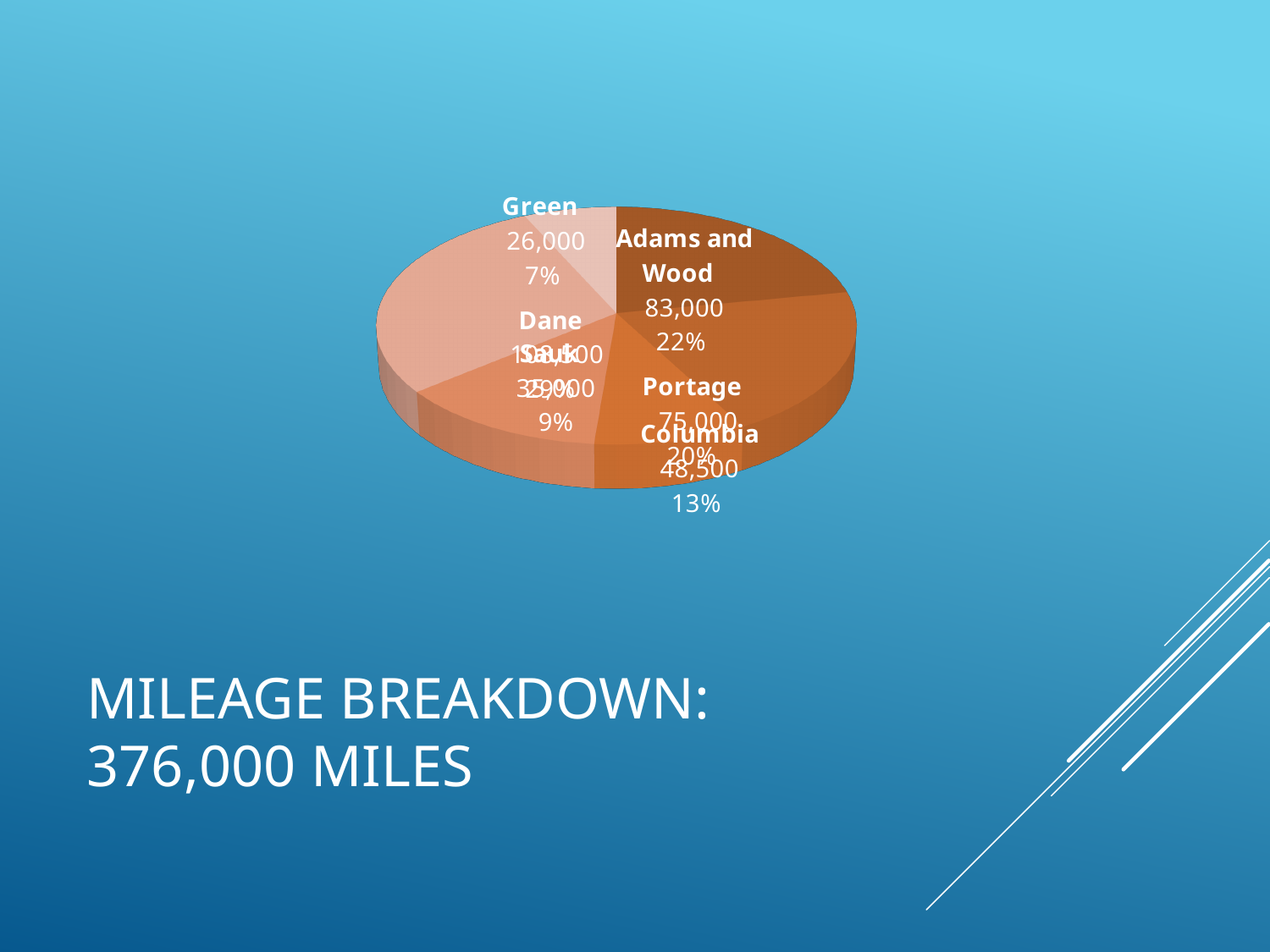
What share of the pie does Green represent? 7% What total mileage does the slide title state? 376,000 miles Which has more miles, Portage or Columbia? Portage What share of the pie does Adams and Wood represent? 22% How many miles are shown for Adams and Wood? 83,000 How many miles are shown for Green? 26,000 What kind of chart is shown on the slide? pie chart What share of the pie does Columbia represent? 13% How many miles are shown for Portage? 75,000 How many slices does the pie chart have? 6 How many miles are shown for Columbia? 48,500 What is the difference in miles between Adams and Wood and Portage? 8,000